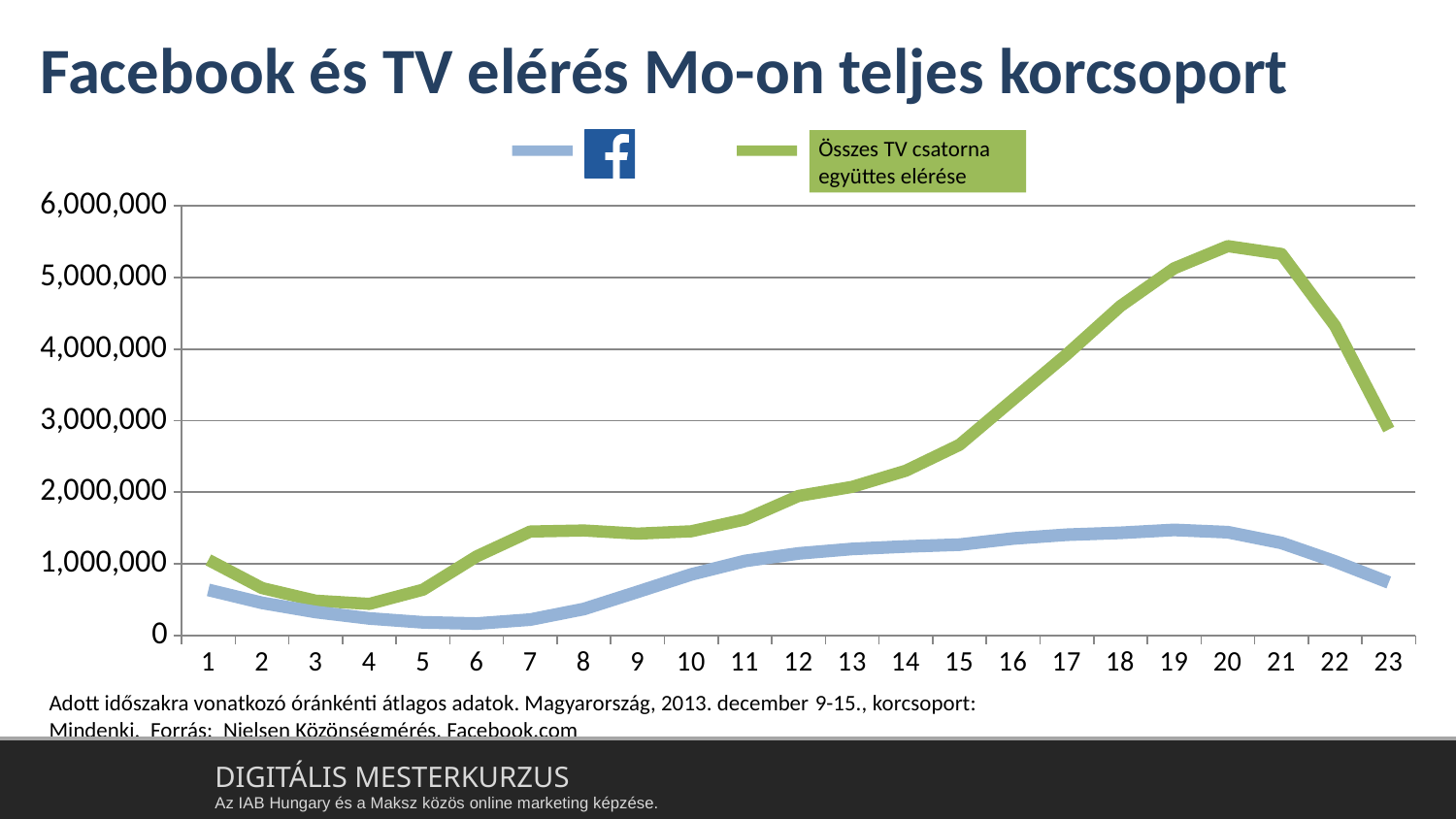
At which x-axis value is the 'Összes TV csatorna együttes elérése' series at its lowest? 4 What kind of chart is shown on the slide? line chart At x-axis value 20, which series has the larger value, Facebook or 'Összes TV csatorna együttes elérése'? Összes TV csatorna együttes elérése Is the value of the Facebook series at 6 greater or less than 1,000,000? less What is the legend label of the green series? Összes TV csatorna együttes elérése At which x-axis value does the 'Összes TV csatorna együttes elérése' series reach its highest point? 20 How many points are plotted along the x axis for each series? 23 Is the value of the 'Összes TV csatorna együttes elérése' series at 20 greater or less than 5,000,000? greater Is the value of the 'Összes TV csatorna együttes elérése' series at 18 greater or less than 4,000,000? greater How many series does the legend list? 2 Does the 'Összes TV csatorna együttes elérése' series rise or fall between 20 and 23 on the x axis? fall